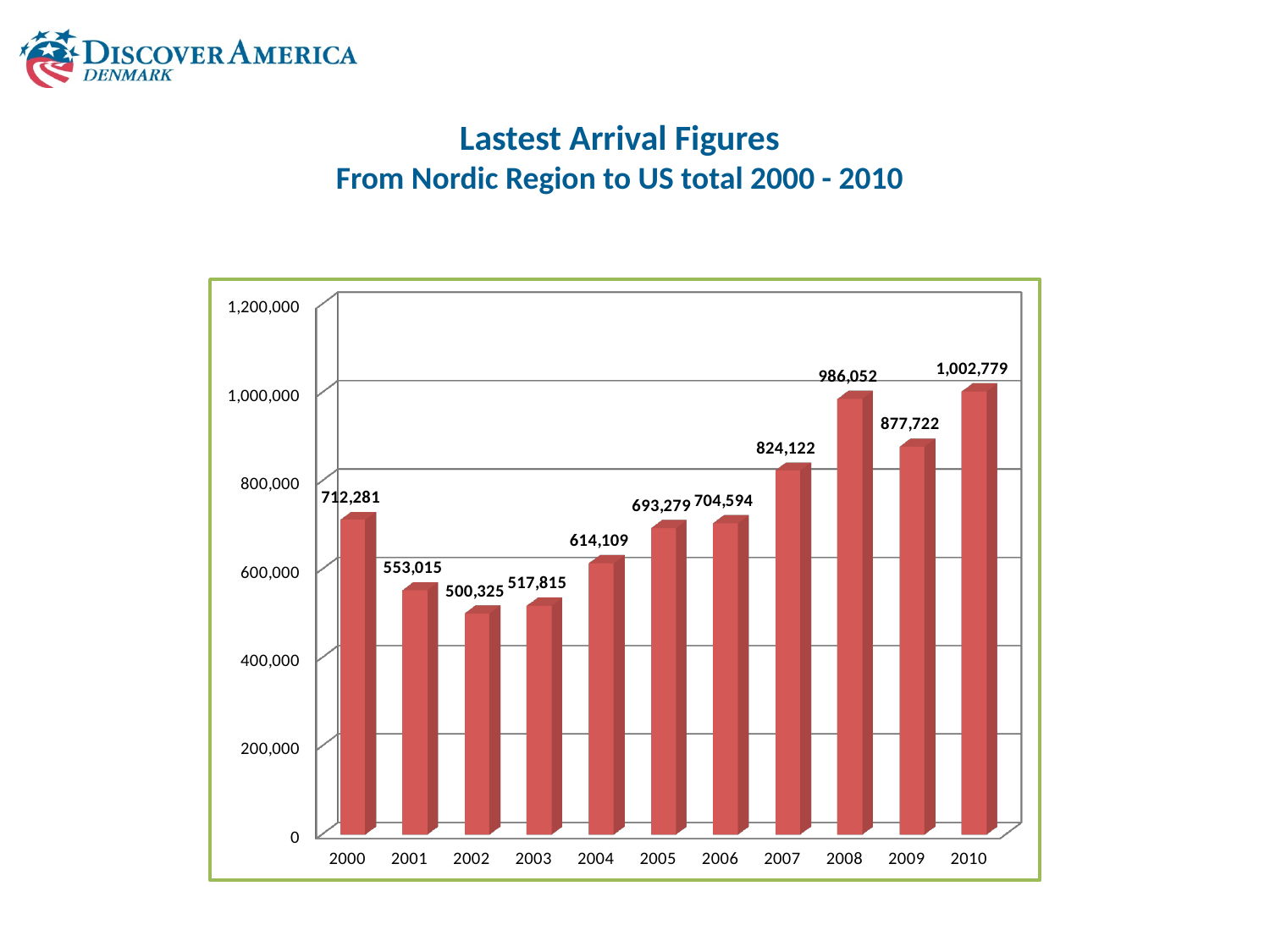
How many years are shown on the x axis? 11 Which year has the highest value? 2010 What is the value for 2010? 1,002,779 Which is larger, the value for 2005 or the value for 2006? 2006 Is the value for 2004 greater or less than 600,000? greater What is the title of the slide above the chart? Lastest Arrival Figures From Nordic Region to US total 2000 - 2010 Which year has the lowest value? 2002 What is the difference between the values for 2010 and 2000? 290,498 What is the value for 2000? 712,281 What is the value for 2007? 824,122 What kind of chart is shown on the slide? bar chart What is the difference between the values for 2008 and 2009? 108,330